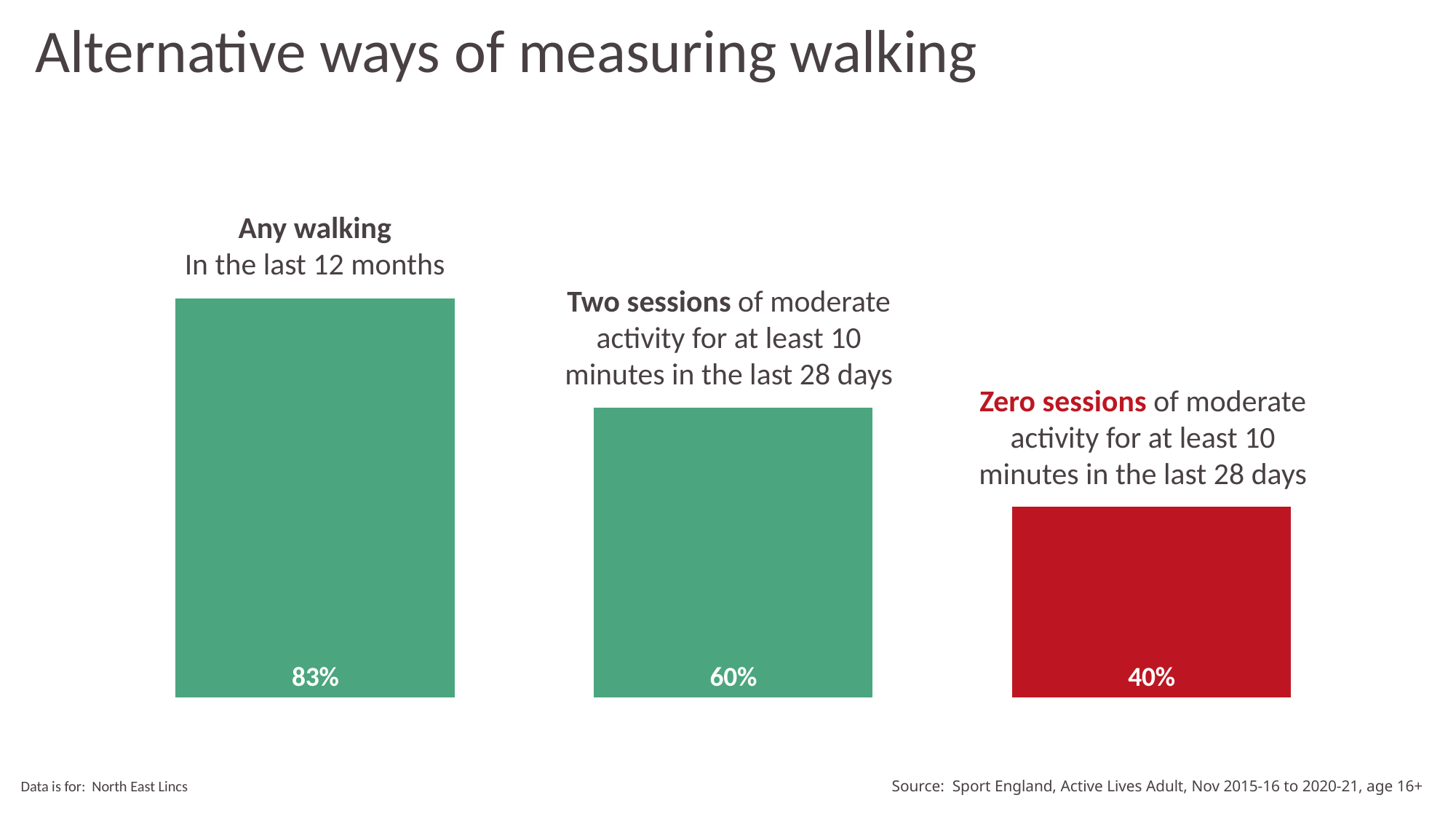
What is the difference between the 'Two sessions' value and the 'Zero sessions' value? 20% What percentage is shown for 'Any walking in the last 12 months'? 83% What kind of chart is shown on the slide? Bar chart How many bars are shown on the chart? 3 Which measure has the highest value? Any walking in the last 12 months What percentage is shown for 'Zero sessions of moderate activity for at least 10 minutes in the last 28 days'? 40% What is the difference between the 'Any walking' value and the 'Two sessions' value? 23% Do the values rise or fall from left to right across the bars? Fall Which measure has the lowest value? Zero sessions of moderate activity for at least 10 minutes in the last 28 days Which is larger: the value for 'Two sessions' or the value for 'Zero sessions'? Two sessions What colour is the bar for 'Zero sessions of moderate activity'? Red What percentage is shown for 'Two sessions of moderate activity for at least 10 minutes in the last 28 days'? 60%